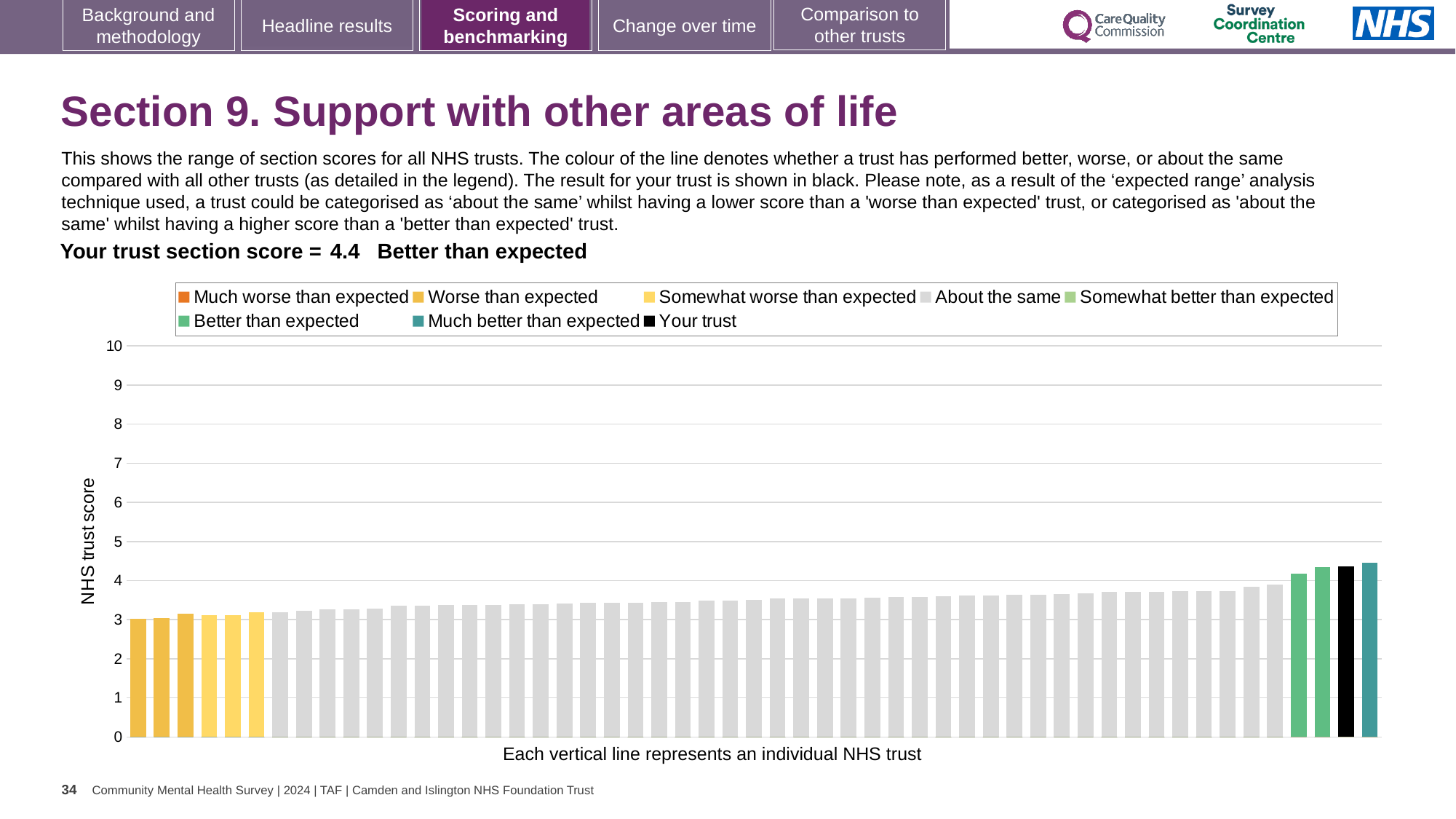
What colour is used for the bar representing your trust? black What kind of chart is shown on the slide? bar chart How is your trust's score categorised compared with other trusts? Better than expected What is the title of the vertical axis? NHS trust score How many entries does the legend list? 8 Is the value of the leftmost bar greater or less than 4? less How many bars are coloured as 'Much better than expected'? 1 Which is larger, the value for your trust or the value of the leftmost bar? your trust What is the section score for your trust? 4.4 Is the value for your trust greater or less than 5? less Is the value for your trust greater or less than 4? greater Do the bar values rise or fall from left to right along the x axis? rise